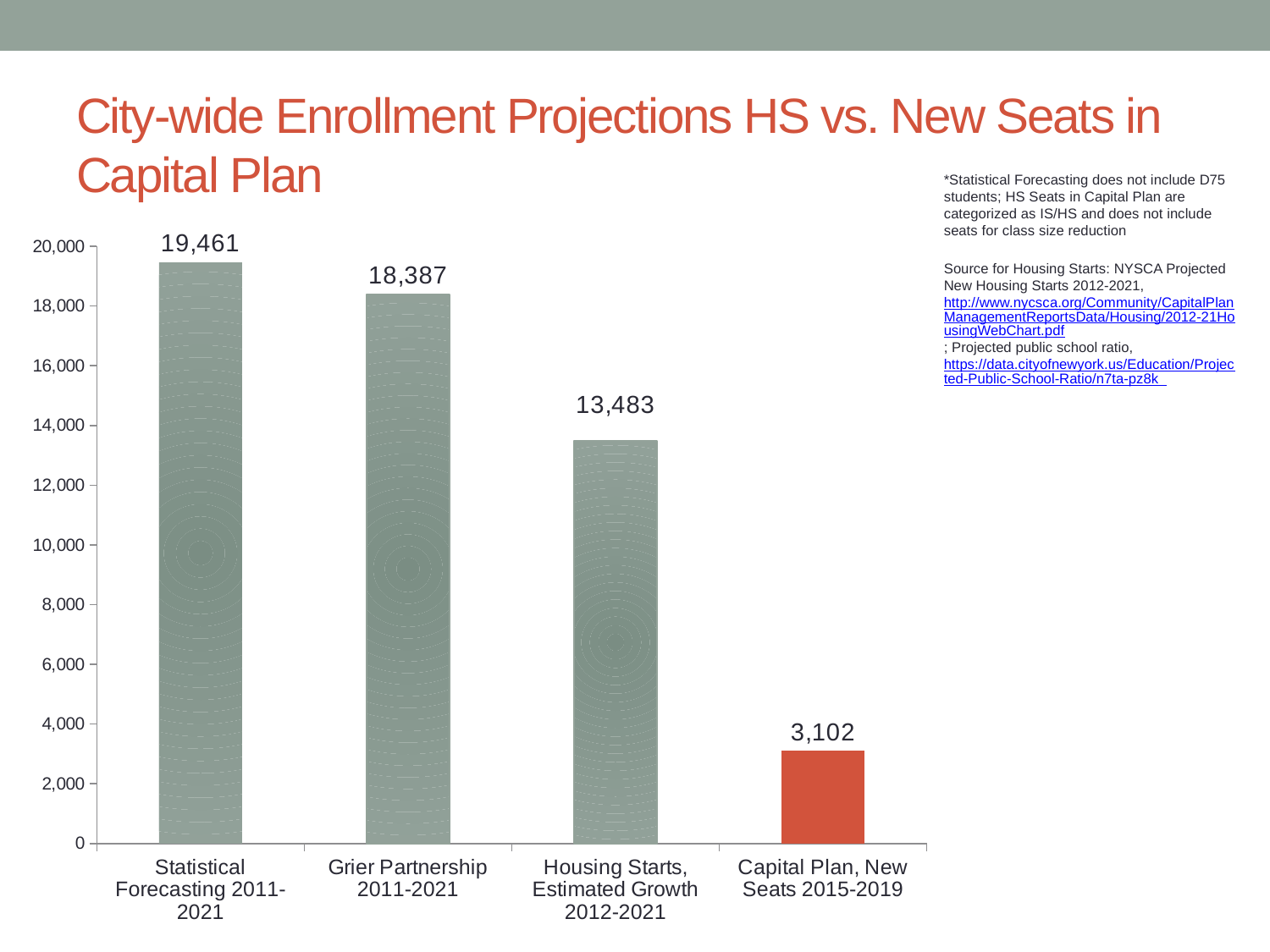
What is the value for Housing Starts, Estimated Growth 2012-2021? 13,483 How many categories are shown in the chart? 4 What is the difference between Statistical Forecasting 2011-2021 and Capital Plan, New Seats 2015-2019? 16,359 What is the difference between Grier Partnership 2011-2021 and Housing Starts, Estimated Growth 2012-2021? 4,904 Which category has the lowest value? Capital Plan, New Seats 2015-2019 What is the value for Statistical Forecasting 2011-2021? 19,461 Which category has the highest value? Statistical Forecasting 2011-2021 Which is larger, Grier Partnership 2011-2021 or Housing Starts, Estimated Growth 2012-2021? Grier Partnership 2011-2021 Which bar is shown in a different colour (orange-red) from the others? Capital Plan, New Seats 2015-2019 What is the value for Grier Partnership 2011-2021? 18,387 What is the value for Capital Plan, New Seats 2015-2019? 3,102 What kind of chart is shown on the slide? Bar chart